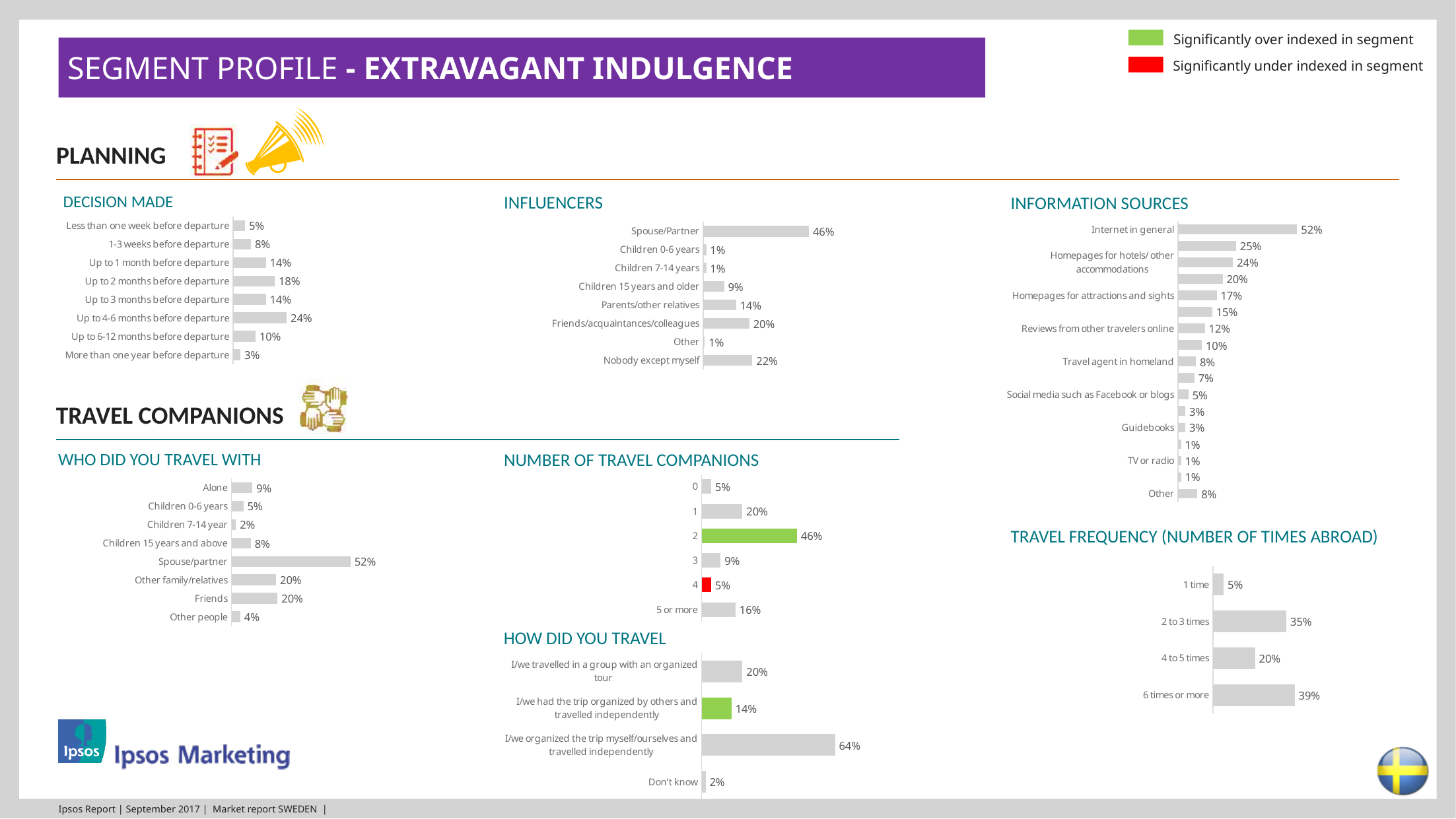
In the INFLUENCERS chart, what is the value for 'Nobody except myself'? 22% In the WHO DID YOU TRAVEL WITH chart, which is larger: 'Alone' or 'Children 15 years and above'? Alone In the WHO DID YOU TRAVEL WITH chart, how many categories are shown? 8 In the TRAVEL FREQUENCY (NUMBER OF TIMES ABROAD) chart, what is the difference between '6 times or more' and '2 to 3 times'? 4% In the HOW DID YOU TRAVEL chart, what is the value for 'I/we organized the trip myself/ourselves and travelled independently'? 64% In the INFLUENCERS chart, which category has the highest value? Spouse/Partner In the INFORMATION SOURCES chart, what is the difference between 'Internet in general' and 'Travel agent in homeland'? 44% In the INFORMATION SOURCES chart, what is the value for 'Internet in general'? 52% In the NUMBER OF TRAVEL COMPANIONS chart, which category is shown with a red bar? 4 In the NUMBER OF TRAVEL COMPANIONS chart, what is the value for '2'? 46% In the DECISION MADE chart, what is the value for 'Up to 4-6 months before departure'? 24% In the DECISION MADE chart, which category has the lowest value? More than one year before departure